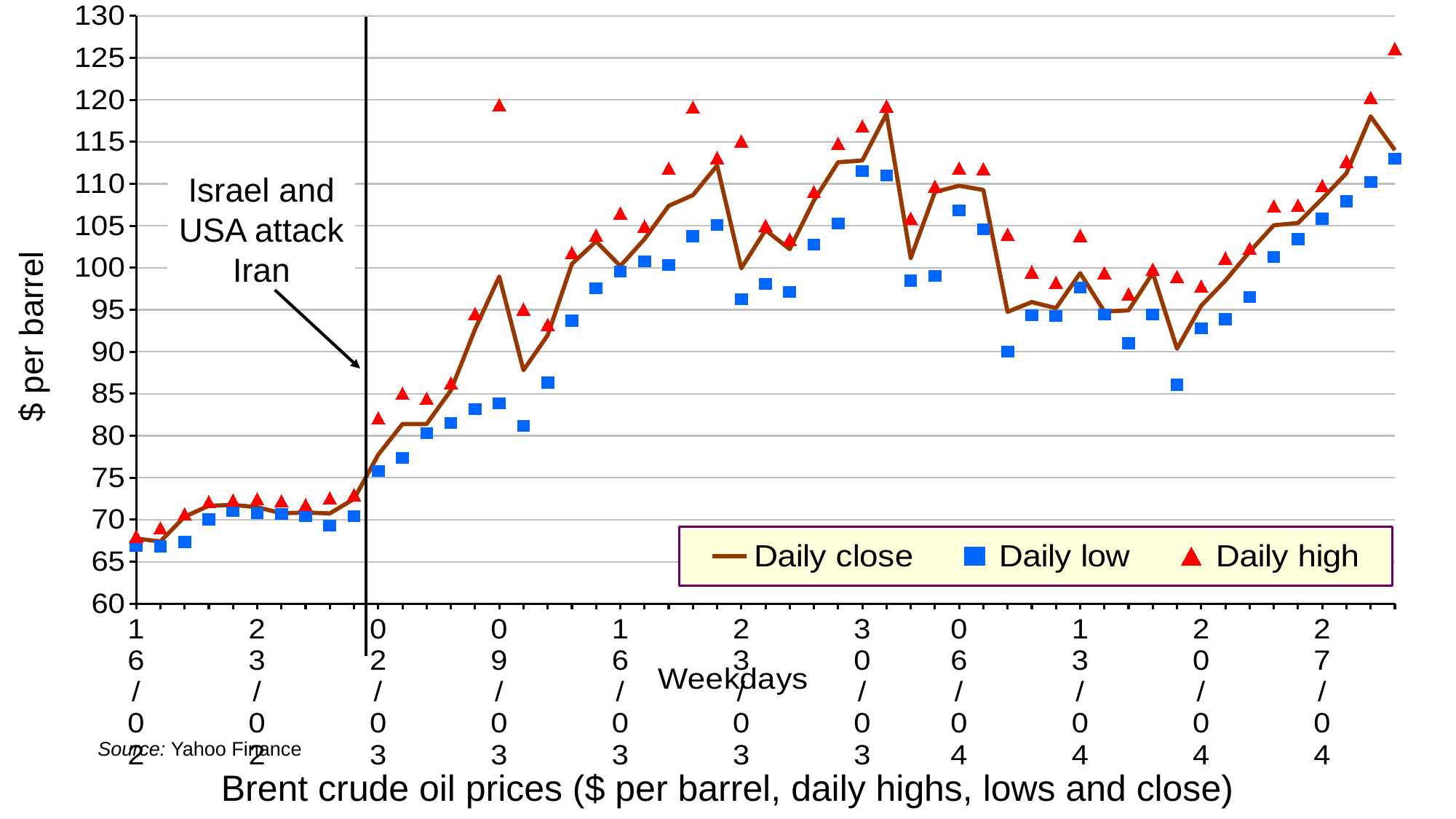
Is the Daily high value on 09/03 greater or less than 115? greater Is the Daily close value on 06/04 greater or less than 105? greater Is the Daily close value on 02/03 greater or less than 70? greater What kind of chart is shown on the slide? line chart How many series does the legend list? 3 Which is larger, the Daily high on 09/03 or the Daily high on 16/03? 09/03 Overall, do the Daily close values rise or fall from 16/02 to the end of the chart? rise What event does the annotation with the vertical line mark? Israel and USA attack Iran What are the three series named in the legend? Daily close, Daily low, Daily high